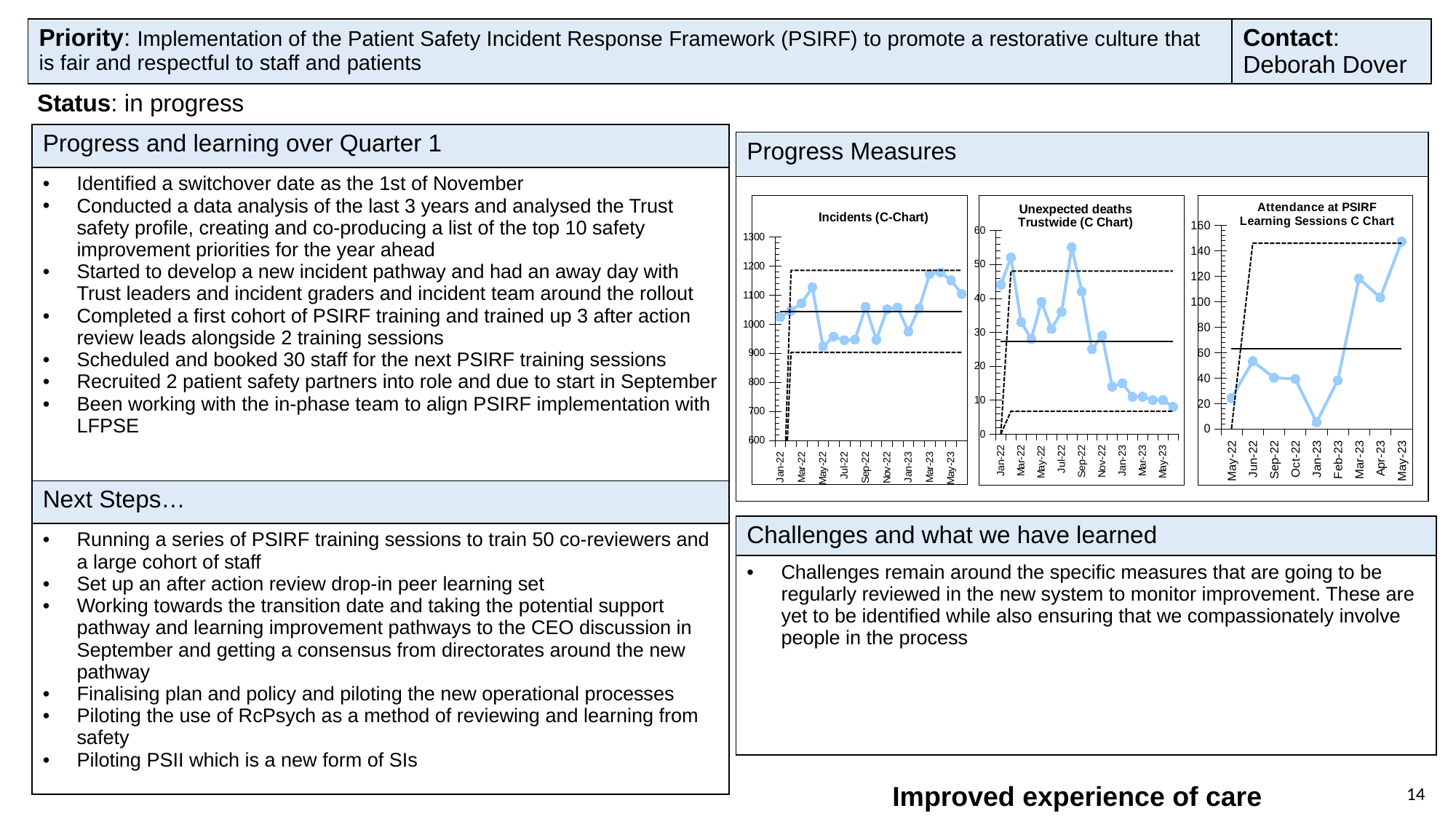
In the 'Incidents (C-Chart)', is the value for May-22 greater or less than 1000? less In the 'Unexpected deaths Trustwide (C Chart)', do the values overall rise or fall from Jan-22 to May-23? fall What kind of chart is the 'Incidents (C-Chart)'? Line chart What is the title of the middle chart in the Progress Measures section? Unexpected deaths Trustwide (C Chart) In the 'Unexpected deaths Trustwide (C Chart)', is the value for Jul-22 greater or less than 50? less In the 'Unexpected deaths Trustwide (C Chart)', is the value for Jan-23 greater or less than 20? less How many charts are shown in the Progress Measures section of the slide? 3 In the 'Attendance at PSIRF Learning Sessions C Chart', which month has the highest attendance? May-23 In the 'Attendance at PSIRF Learning Sessions C Chart', which month has the lowest attendance? Jan-23 How many data points are plotted in the 'Attendance at PSIRF Learning Sessions C Chart'? 9